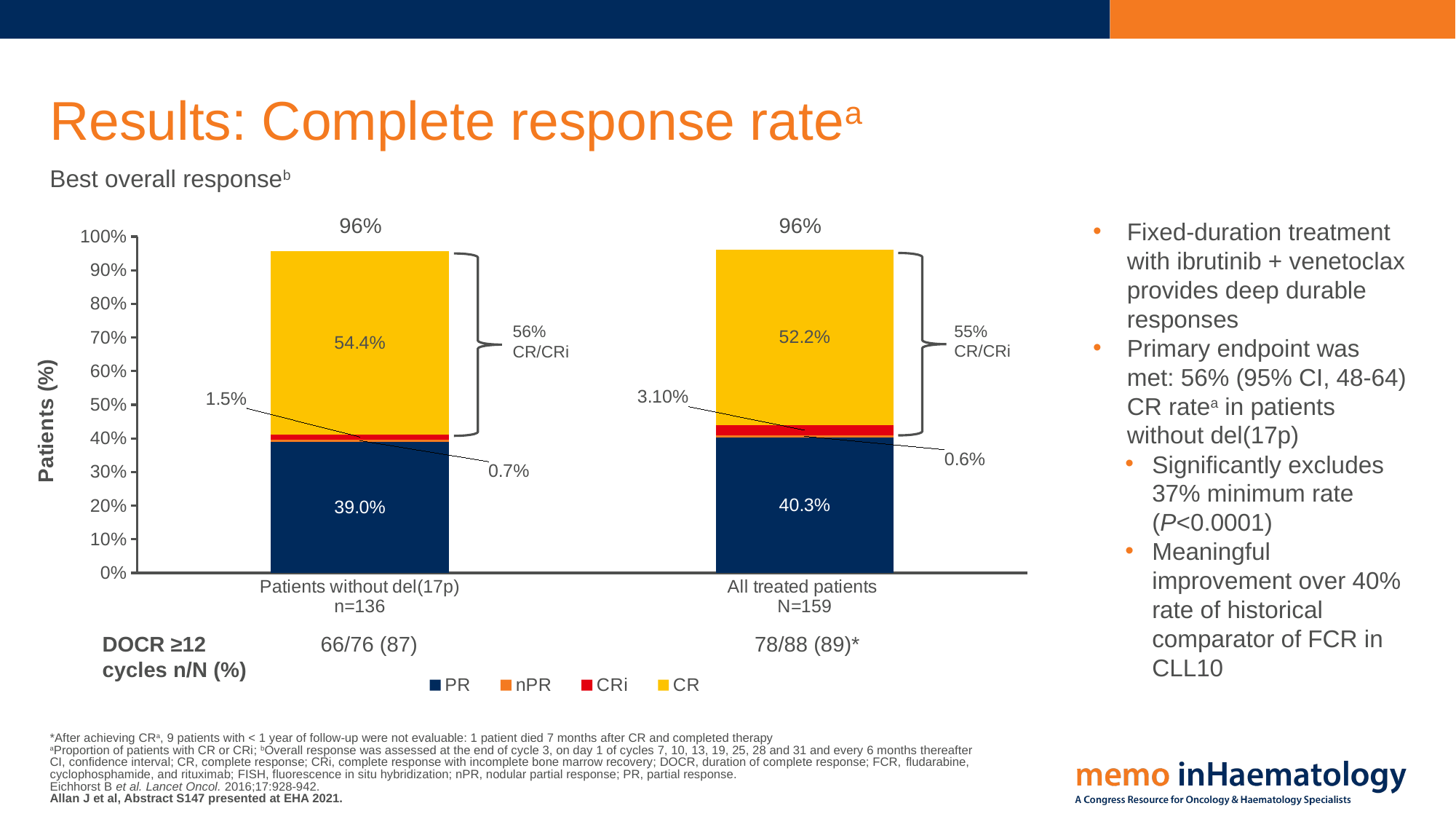
Which group has the larger PR value, patients without del(17p) or all treated patients? All treated patients What CR/CRi rate is indicated by the bracket for all treated patients? 55% What is the CR value for patients without del(17p)? 54.4% What kind of chart is shown on the slide? Stacked bar chart What is the overall response total shown above the bar for all treated patients? 96% How many series does the chart legend list? 4 How many patient groups (bars) are plotted in the chart? 2 What is the label on the y-axis of the chart? Patients (%) What is the PR value for all treated patients? 40.3% Which colour represents CR in the chart legend? Yellow Which group has the higher CR/CRi rate shown by the brackets? Patients without del(17p) What is the difference between the CR value for patients without del(17p) and the CR value for all treated patients? 2.2 percentage points